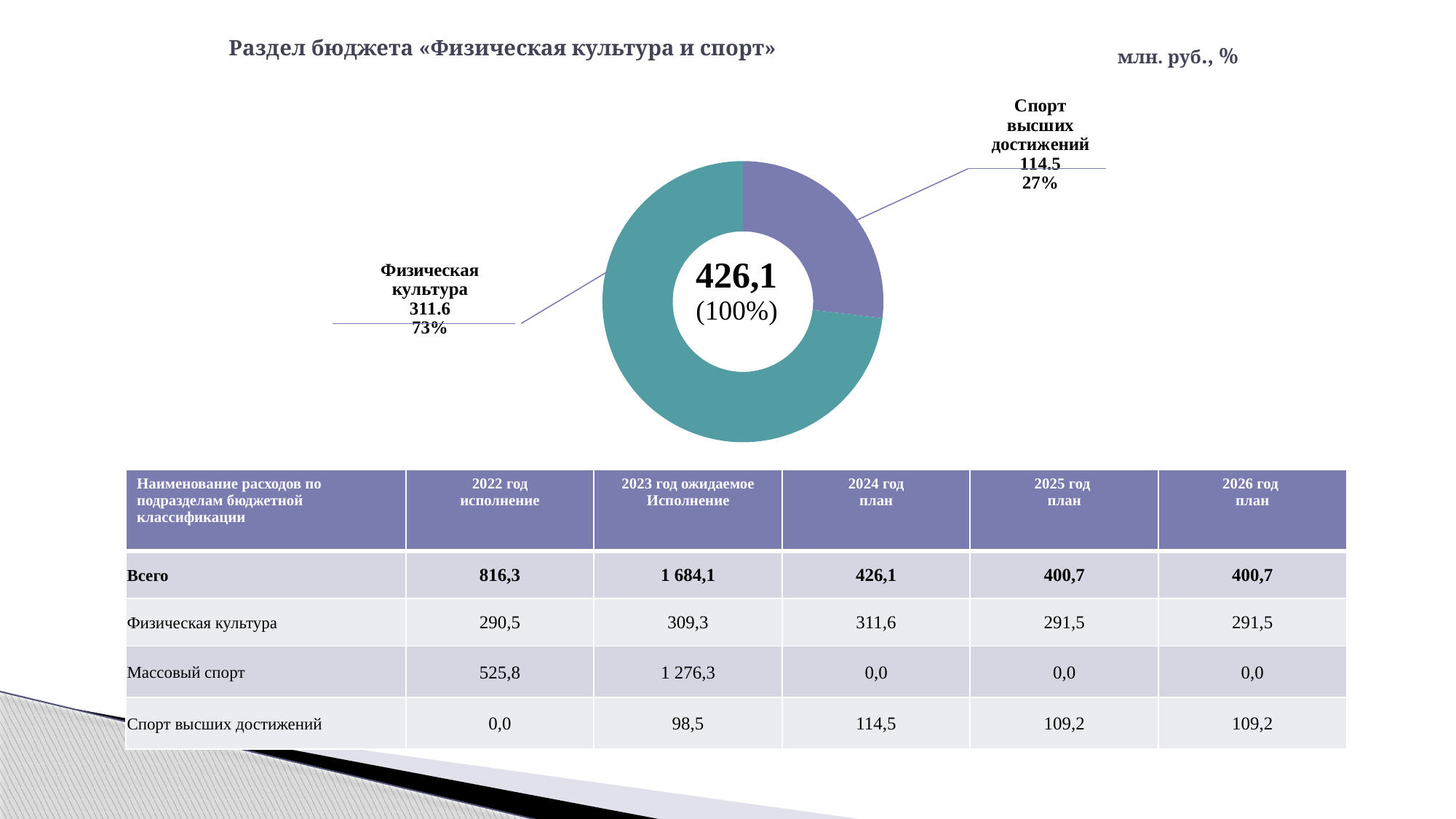
What is the value shown for Физическая культура in the pie chart? 311.6 Which is larger in the pie chart: Физическая культура or Спорт высших достижений? Физическая культура What is the difference between the values for Физическая культура and Спорт высших достижений in the pie chart? 197.1 What units are indicated for the chart in the top right of the slide? млн. руб., % How many slices does the pie chart have? 2 What share of the pie does Физическая культура represent? 73% What type of chart is shown on the slide? Pie chart (donut) What total value is shown in the centre of the donut chart? 426,1 Which slice of the pie chart is the largest? Физическая культура Which slice of the pie chart is the smallest? Спорт высших достижений What share of the pie does Спорт высших достижений represent? 27% What is the value shown for Спорт высших достижений in the pie chart? 114.5